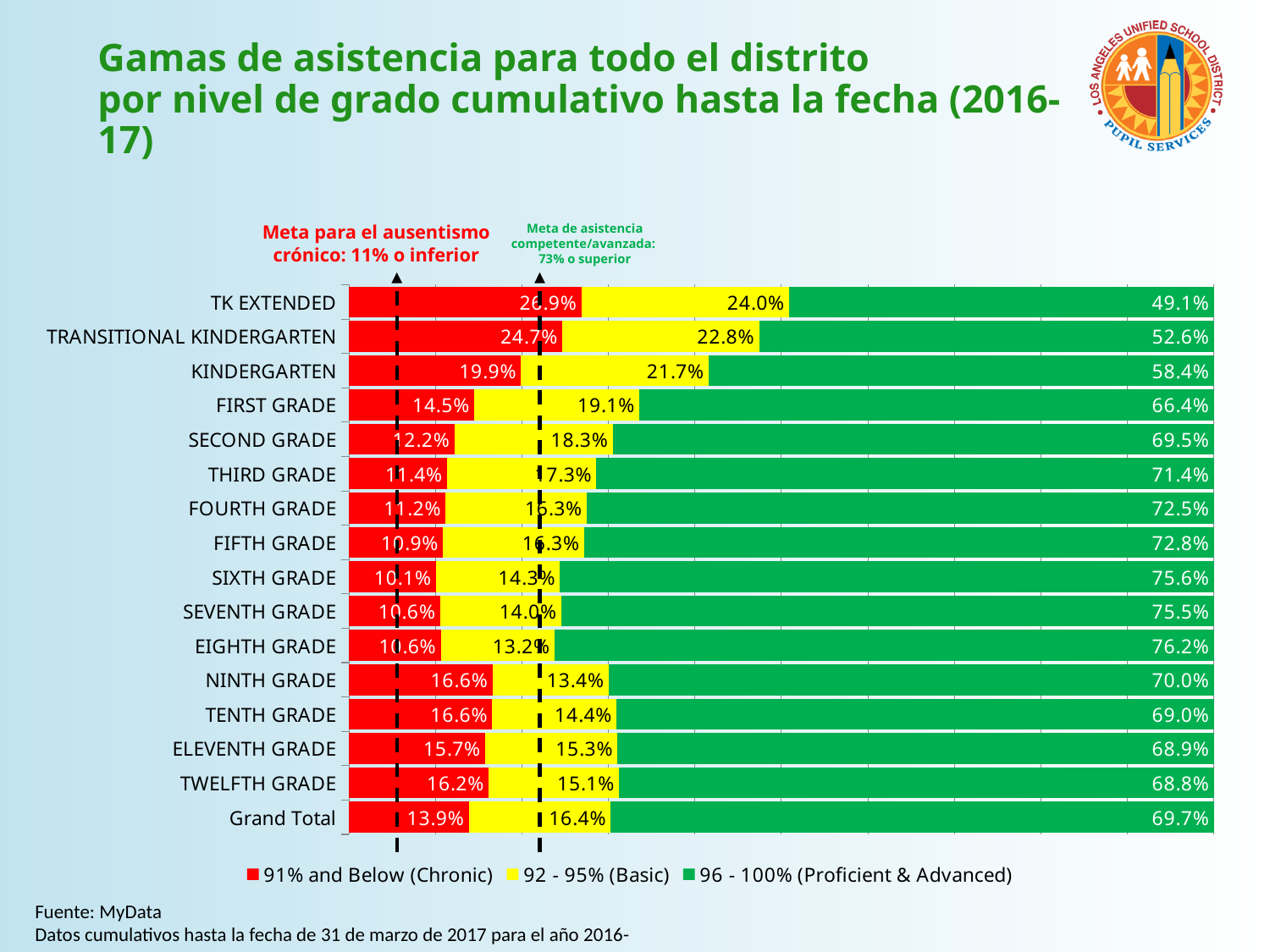
How many series does the legend list? 3 Which has a larger 92 - 95% (Basic) value, SECOND GRADE or TENTH GRADE? SECOND GRADE What is the value for 92 - 95% (Basic) for FIRST GRADE? 19.1% How many grade-level categories (including Grand Total) are shown on the chart? 16 What is the difference between the 96 - 100% (Proficient & Advanced) values for SIXTH GRADE and TWELFTH GRADE? 6.8% What is the value for 91% and Below (Chronic) for NINTH GRADE? 16.6% What is the value for 96 - 100% (Proficient & Advanced) for KINDERGARTEN? 58.4% What kind of chart is shown on the slide? Stacked bar chart Which grade level has the highest value for 96 - 100% (Proficient & Advanced)? EIGHTH GRADE What is the value for 96 - 100% (Proficient & Advanced) for Grand Total? 69.7% Which grade level has the lowest value for 96 - 100% (Proficient & Advanced)? TK EXTENDED Which colour represents the 91% and Below (Chronic) series? Red